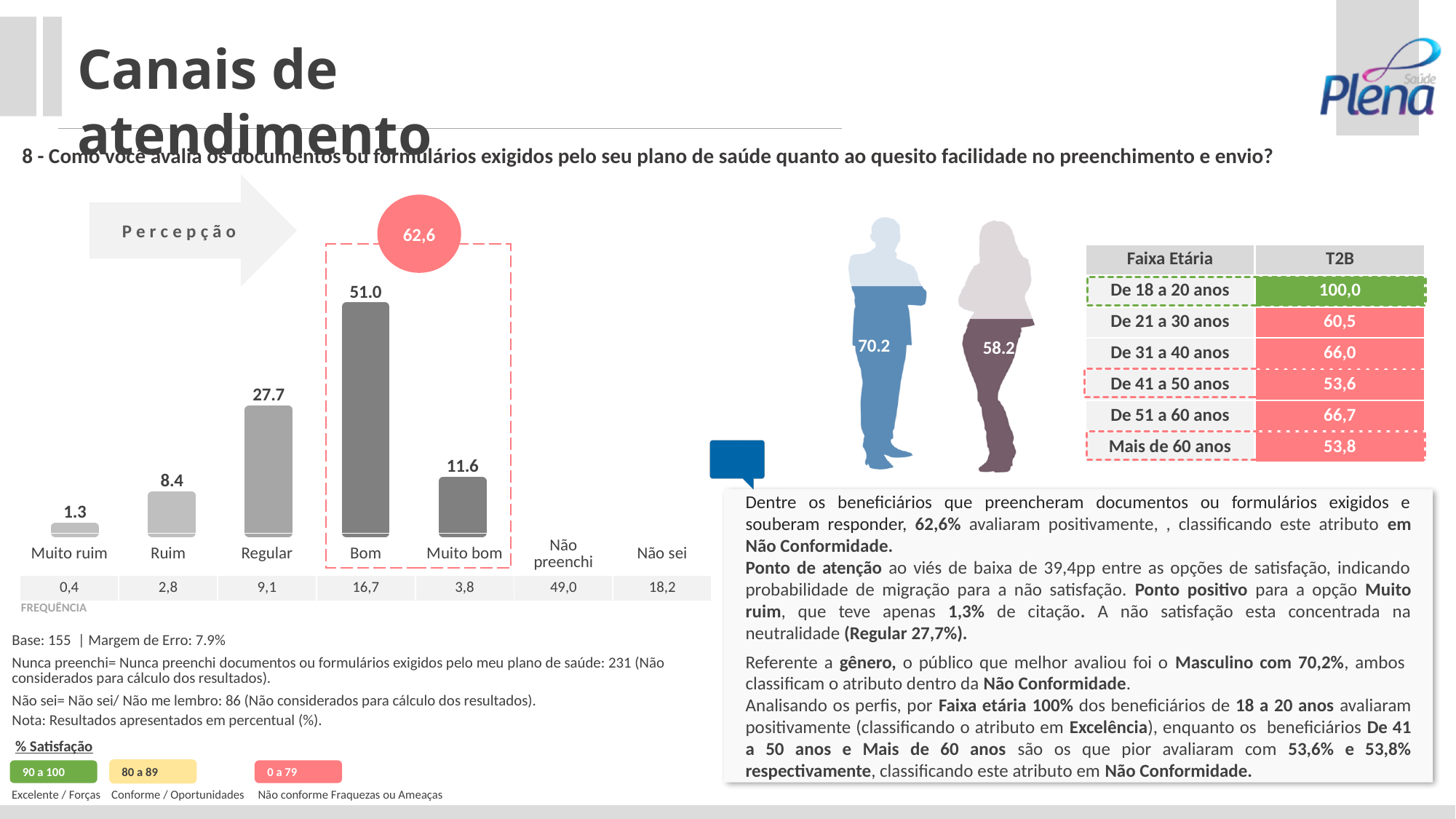
What is the value for Muito ruim in the bar chart? 1.3 In the Faixa Etária table, what is the T2B value for De 18 a 20 anos? 100,0 Which category has the highest bar in the chart? Bom What is the difference between the T2B values for De 51 a 60 anos and De 21 a 30 anos in the table? 6,2 What is the difference between the values for Bom and Muito bom in the bar chart? 39.4 Which is larger in the bar chart, Ruim or Muito bom? Muito bom What is the value for Regular in the bar chart? 27.7 Which category has the lowest bar in the chart? Muito ruim What kind of chart is shown on the left of the slide? Bar chart In the Faixa Etária table, which age group has the lowest T2B value? De 41 a 50 anos What value is shown in the pink circle above the Bom and Muito bom bars? 62,6 What is the value for Bom in the bar chart? 51.0